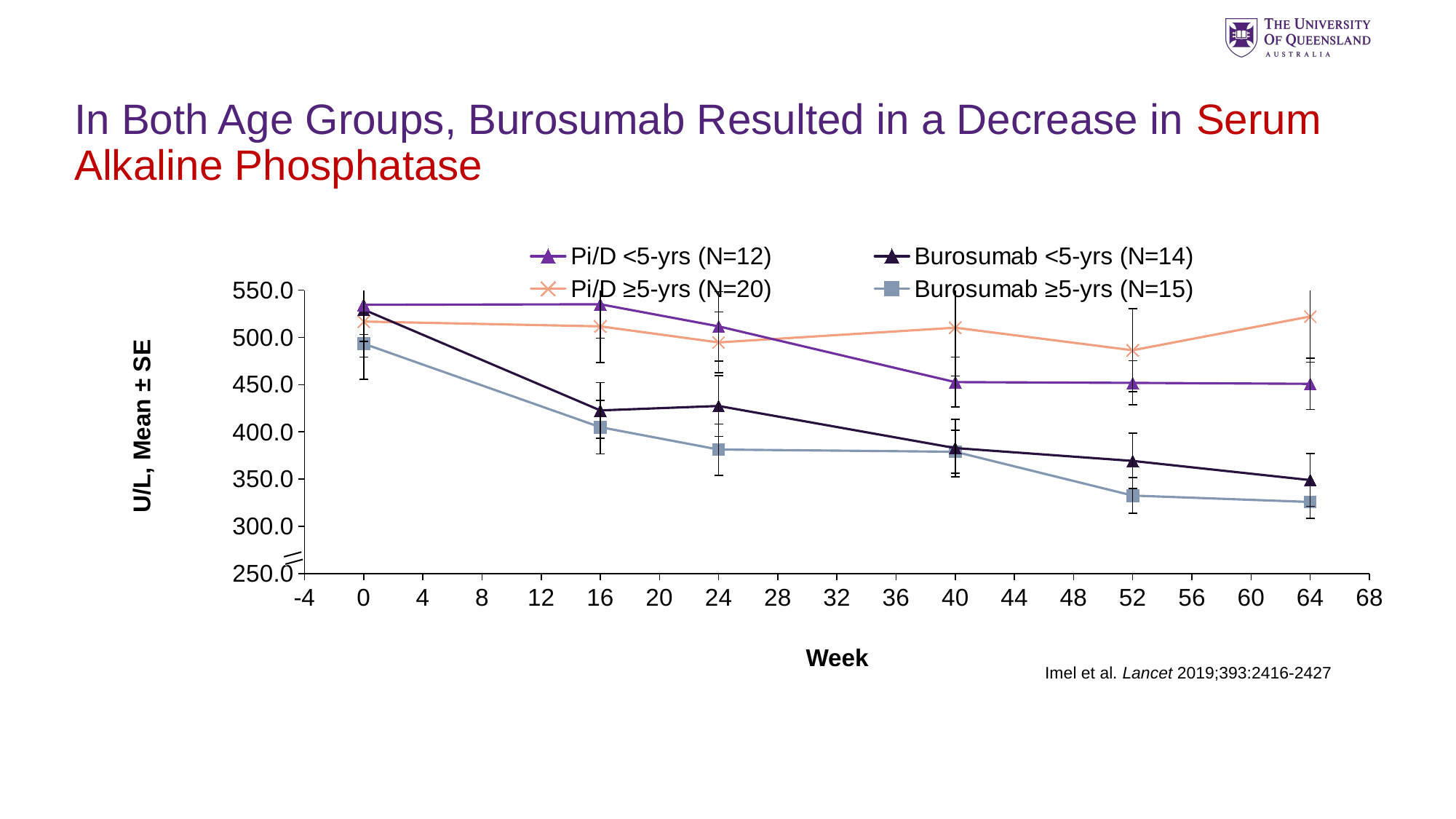
At week 64, which is larger: Pi/D ≥5-yrs (N=20) or Burosumab ≥5-yrs (N=15)? Pi/D ≥5-yrs (N=20) How many series does the legend list? 4 Is the value for Burosumab <5-yrs (N=14) at week 16 greater or less than 400? greater Does the value for Burosumab ≥5-yrs (N=15) rise or fall from week 0 to week 64? fall At how many weeks are data points plotted for each series? 6 Is the value for Pi/D ≥5-yrs (N=20) at week 64 greater or less than 500? greater What is the label on the y axis? U/L, Mean ± SE What kind of chart is shown on the slide? line chart Which series has the highest value at week 64? Pi/D ≥5-yrs (N=20) Is the value for Burosumab ≥5-yrs (N=15) at week 64 greater or less than 350? less Which series has the lowest value at week 64? Burosumab ≥5-yrs (N=15)